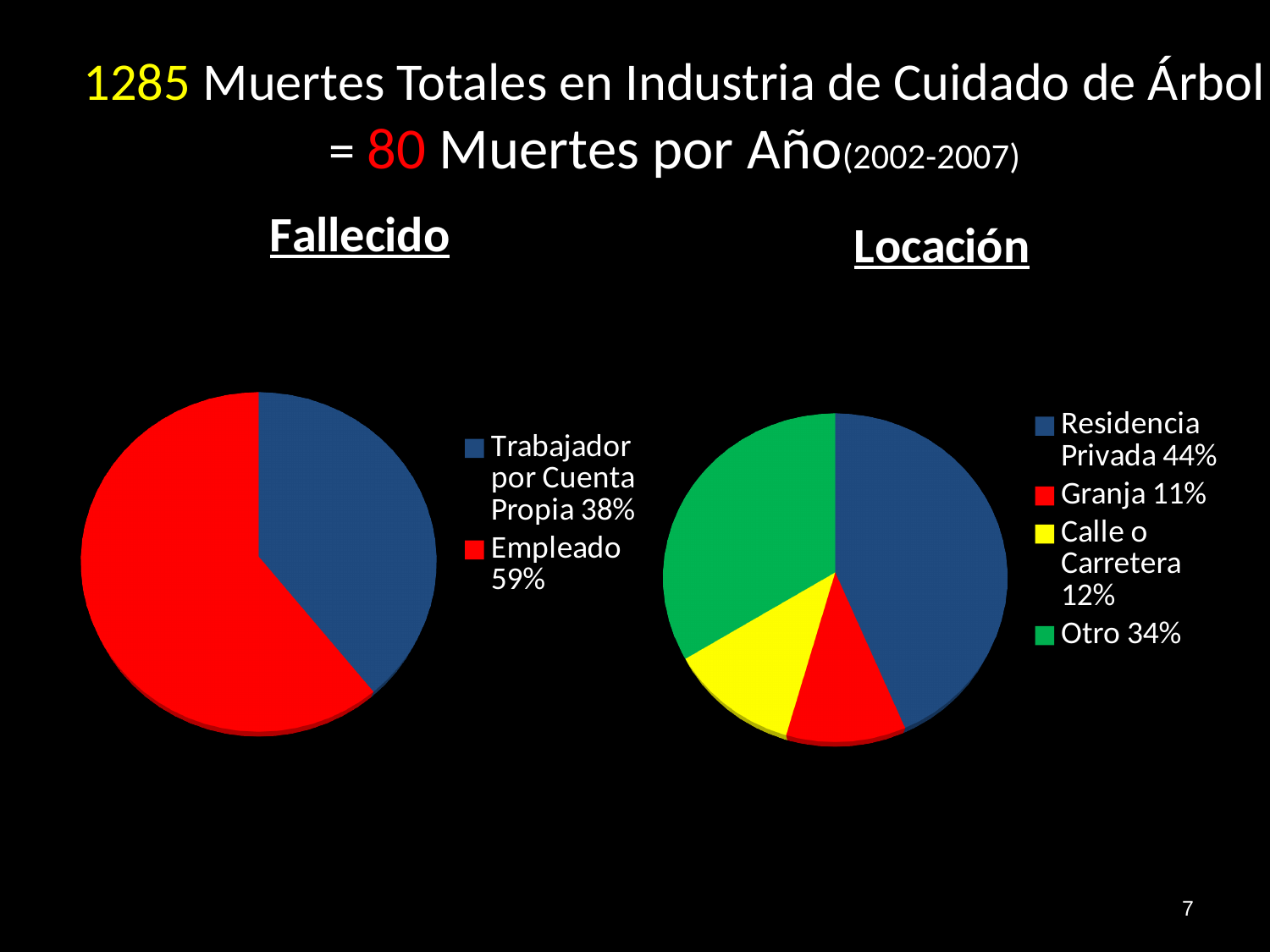
In the Fallecido pie chart, which category has the larger share? Empleado What type of chart is used for Locación? Pie chart In the Fallecido pie chart, how many slices does the pie have? 2 In the Locación pie chart, which category has the smallest share? Granja In the Locación pie chart, what share is labelled for Residencia Privada? 44% In the Fallecido pie chart, what share is labelled for Empleado? 59% In the Locación pie chart, which category has the largest share? Residencia Privada In the Locación pie chart, what share is labelled for Granja? 11% In the Fallecido pie chart, what share is labelled for Trabajador por Cuenta Propia? 38% In the Locación pie chart, what is the difference in percentage points between Residencia Privada and Otro? 10 In the Locación pie chart, how many categories does the legend list? 4 In the Locación pie chart, what share is labelled for Calle o Carretera? 12%